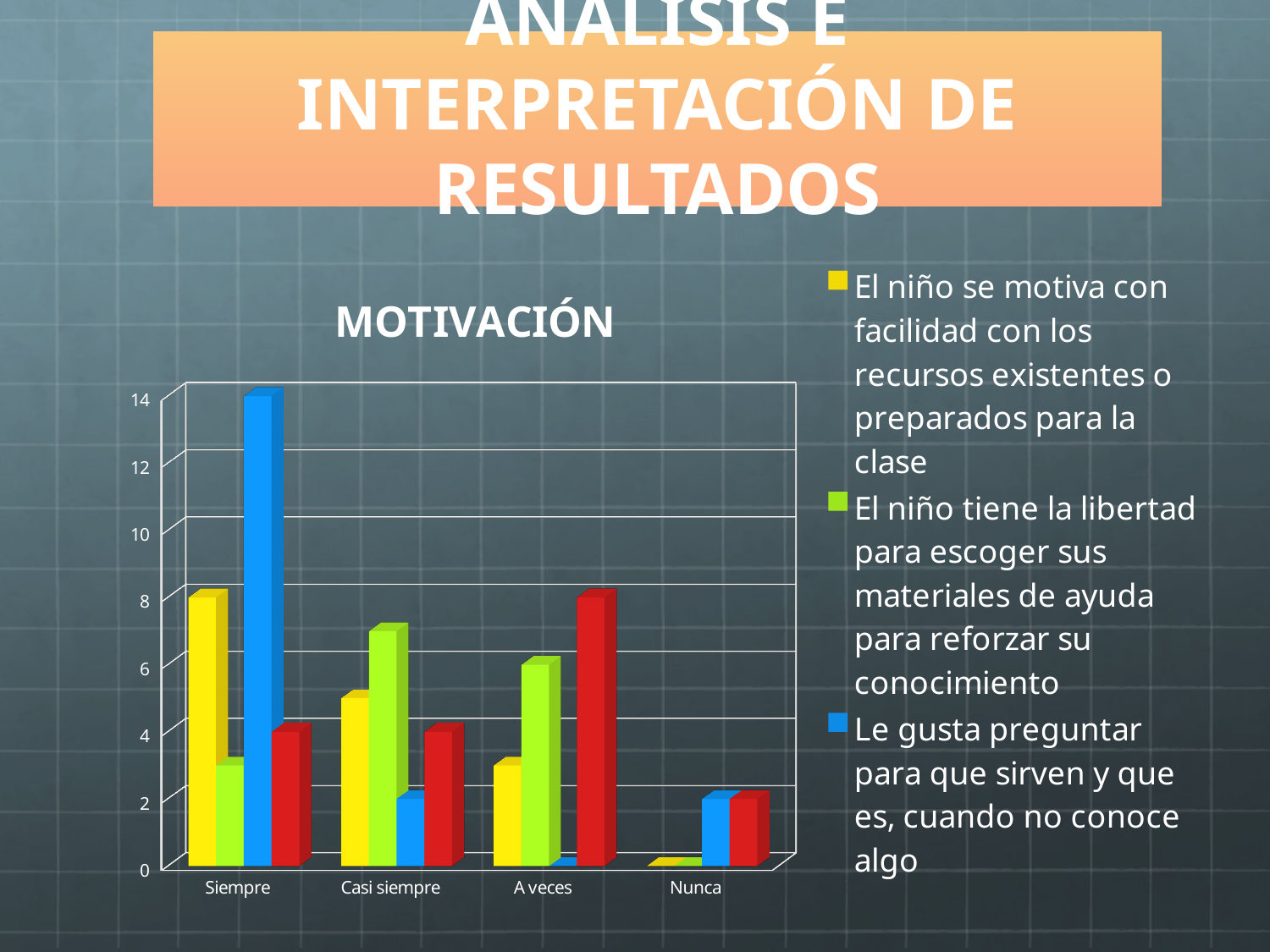
Is the red bar for A veces greater or less than 6? greater Which category has the tallest bar in the chart? Siempre Is the blue bar ("Le gusta preguntar para que sirven y que es, cuando no conoce algo") for Siempre greater or less than 10? greater How many categories are shown on the x axis of the chart? 4 For Casi siempre, which is taller: the yellow bar or the green bar? The green bar What kind of chart is shown on the slide? Bar chart Do the values of the yellow series rise or fall from Siempre to Nunca? Fall What is the title of the chart? MOTIVACIÓN For A veces, which is taller: the red bar or the yellow bar? The red bar For the yellow series, which category has the lowest value? Nunca Is the yellow bar ("El niño se motiva con facilidad con los recursos existentes o preparados para la clase") for Siempre greater or less than 6? greater How many series does the legend list? 3